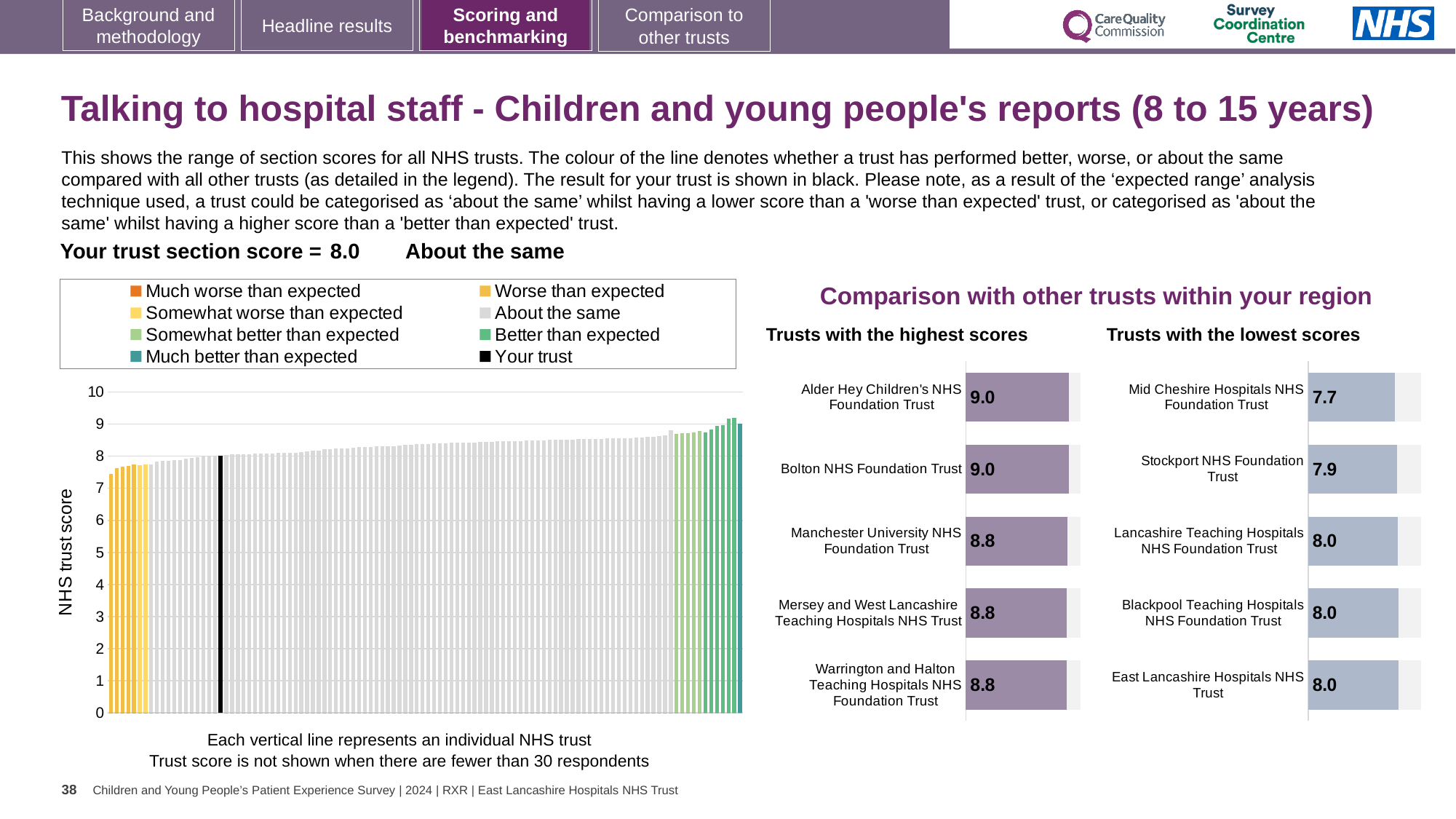
In the large chart on the left, do the bar values rise or fall from left to right along the x axis? Rise How many trusts are shown in the 'Trusts with the highest scores' chart? 5 What kind of chart is the large chart on the left showing NHS trust scores? Bar chart In the 'Trusts with the lowest scores' chart, what is the score for Mid Cheshire Hospitals NHS Foundation Trust? 7.7 In the 'Trusts with the highest scores' chart, what is the score for Manchester University NHS Foundation Trust? 8.8 What is the y-axis label of the large chart on the left? NHS trust score In the 'Trusts with the lowest scores' chart, which has the larger score: Stockport NHS Foundation Trust or Mid Cheshire Hospitals NHS Foundation Trust? Stockport NHS Foundation Trust In the 'Trusts with the lowest scores' chart, what is the score for Stockport NHS Foundation Trust? 7.9 In the 'Trusts with the highest scores' chart, what is the score for Alder Hey Children's NHS Foundation Trust? 9.0 In the large chart on the left, is the value of the tallest bar greater or less than 10? less In the 'Trusts with the highest scores' chart, what is the difference between the scores of Alder Hey Children's NHS Foundation Trust and Warrington and Halton Teaching Hospitals NHS Foundation Trust? 0.2 In the 'Trusts with the lowest scores' chart, which trust has the lowest score? Mid Cheshire Hospitals NHS Foundation Trust